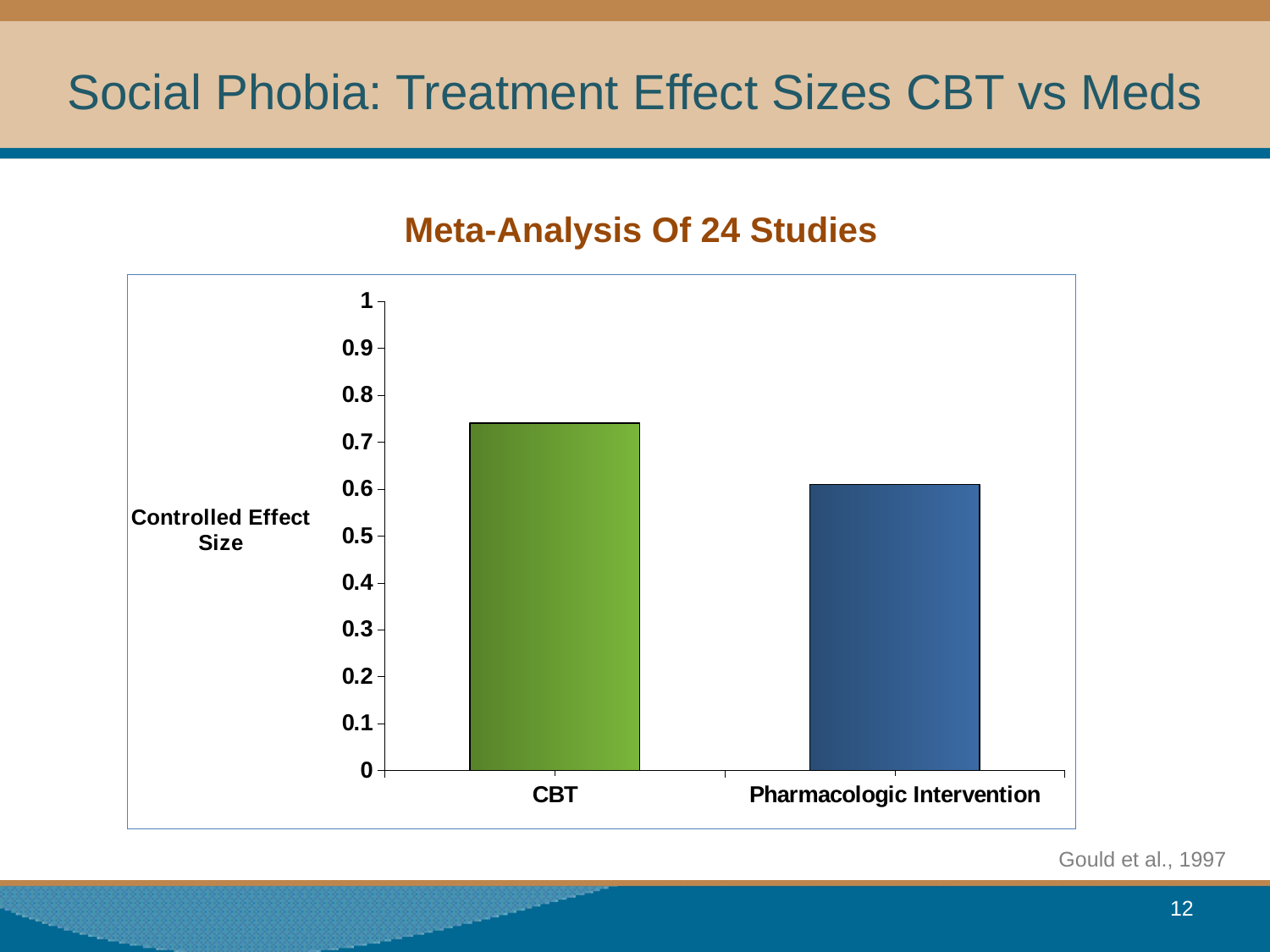
What kind of chart is shown on the slide? bar chart Which has a larger controlled effect size, CBT or Pharmacologic Intervention? CBT How many categories are plotted in the chart? 2 What is the title shown above the chart? Meta-Analysis Of 24 Studies What is the label on the vertical axis of the chart? Controlled Effect Size Which category has the lowest controlled effect size? Pharmacologic Intervention Is the value for Pharmacologic Intervention greater or less than 0.7? less Is the value for CBT greater or less than 0.8? less Which category has the highest controlled effect size? CBT Is the value for CBT greater or less than 0.7? greater